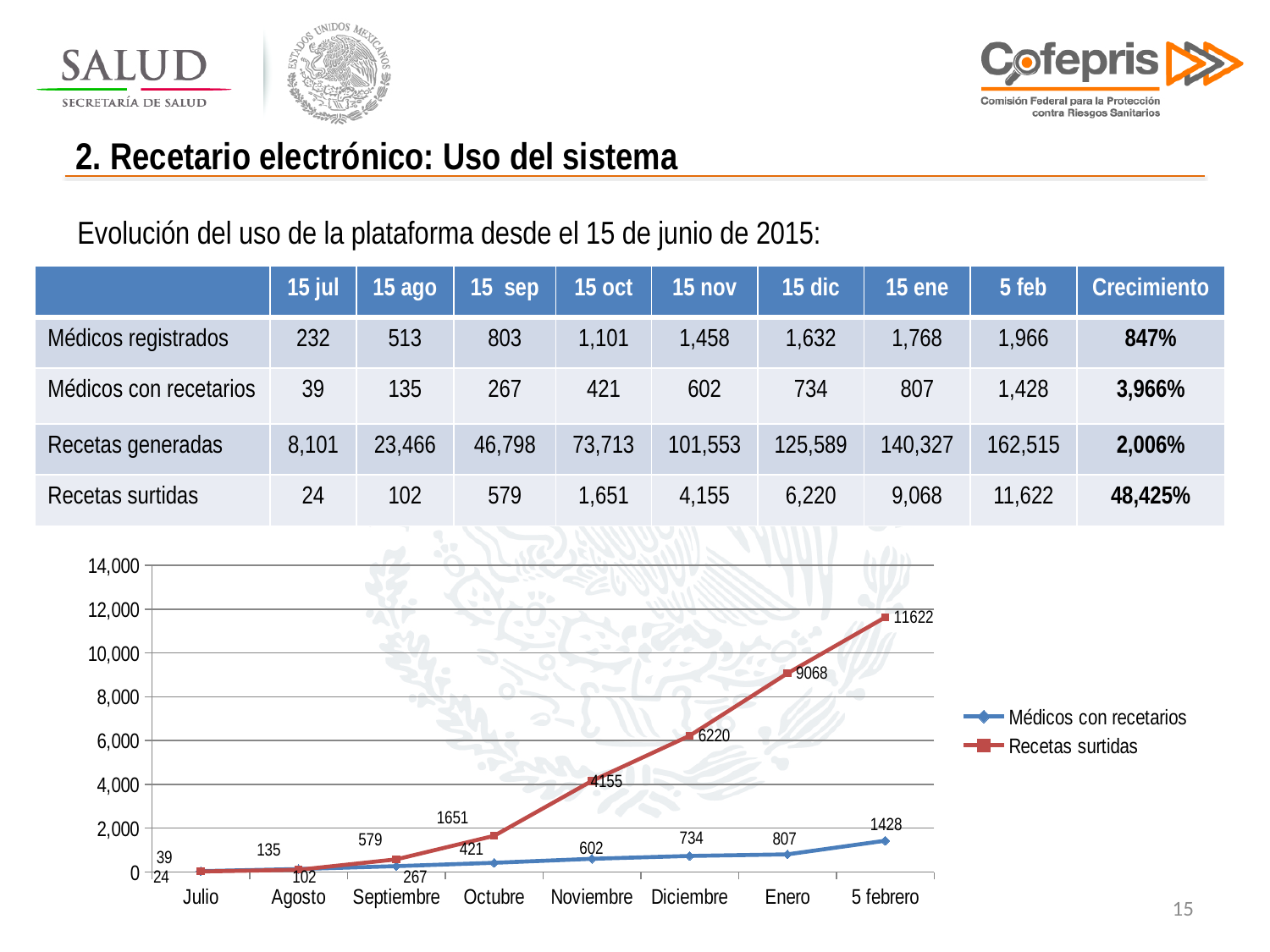
How many categories are shown on the x axis of the chart? 8 Is the value of Recetas surtidas for Enero greater or less than 8,000? greater How many series does the chart legend list? 2 What type of chart is shown on the slide? line chart Which is larger in Septiembre: Recetas surtidas or Médicos con recetarios? Recetas surtidas In which month is Recetas surtidas highest in the chart? 5 febrero What is the value of Recetas surtidas for Octubre in the chart? 1651 Does the Recetas surtidas series rise or fall from Julio to 5 febrero? rise What is the value of Médicos con recetarios for Noviembre in the chart? 602 What is the value of Recetas surtidas for 5 febrero in the chart? 11622 What is the difference between Recetas surtidas in Enero and in Diciembre in the chart? 2848 In which month is Médicos con recetarios lowest in the chart? Julio